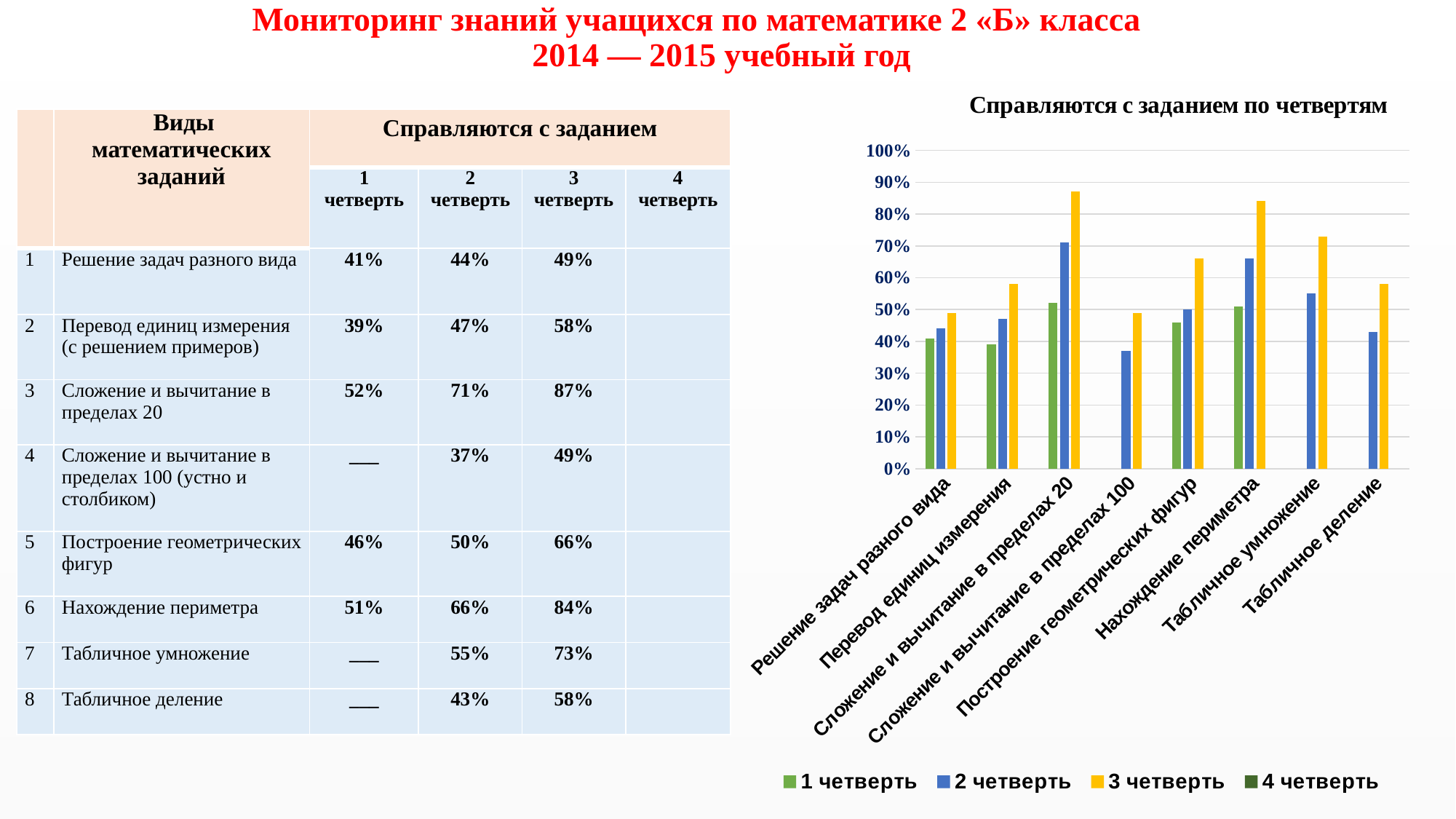
Which category has the lowest value for 2 четверть? Сложение и вычитание в пределах 100 How many series does the chart legend list? 4 What is the difference between the 3 четверть and 1 четверть values for Нахождение периметра? 33% Is the value for 3 четверть for Перевод единиц измерения greater or less than 50%? greater What is the title of the chart? Справляются с заданием по четвертям What kind of chart is shown on the slide? bar chart How many categories are shown along the x axis of the chart? 8 Which is larger for 3 четверть: Табличное умножение or Табличное деление? Табличное умножение What colour represents 3 четверть in the chart? yellow Which category has the highest value for 3 четверть? Сложение и вычитание в пределах 20 For Решение задач разного вида, do the values rise or fall from 1 четверть to 3 четверть? rise What is the value for 3 четверть for Сложение и вычитание в пределах 20? 87%